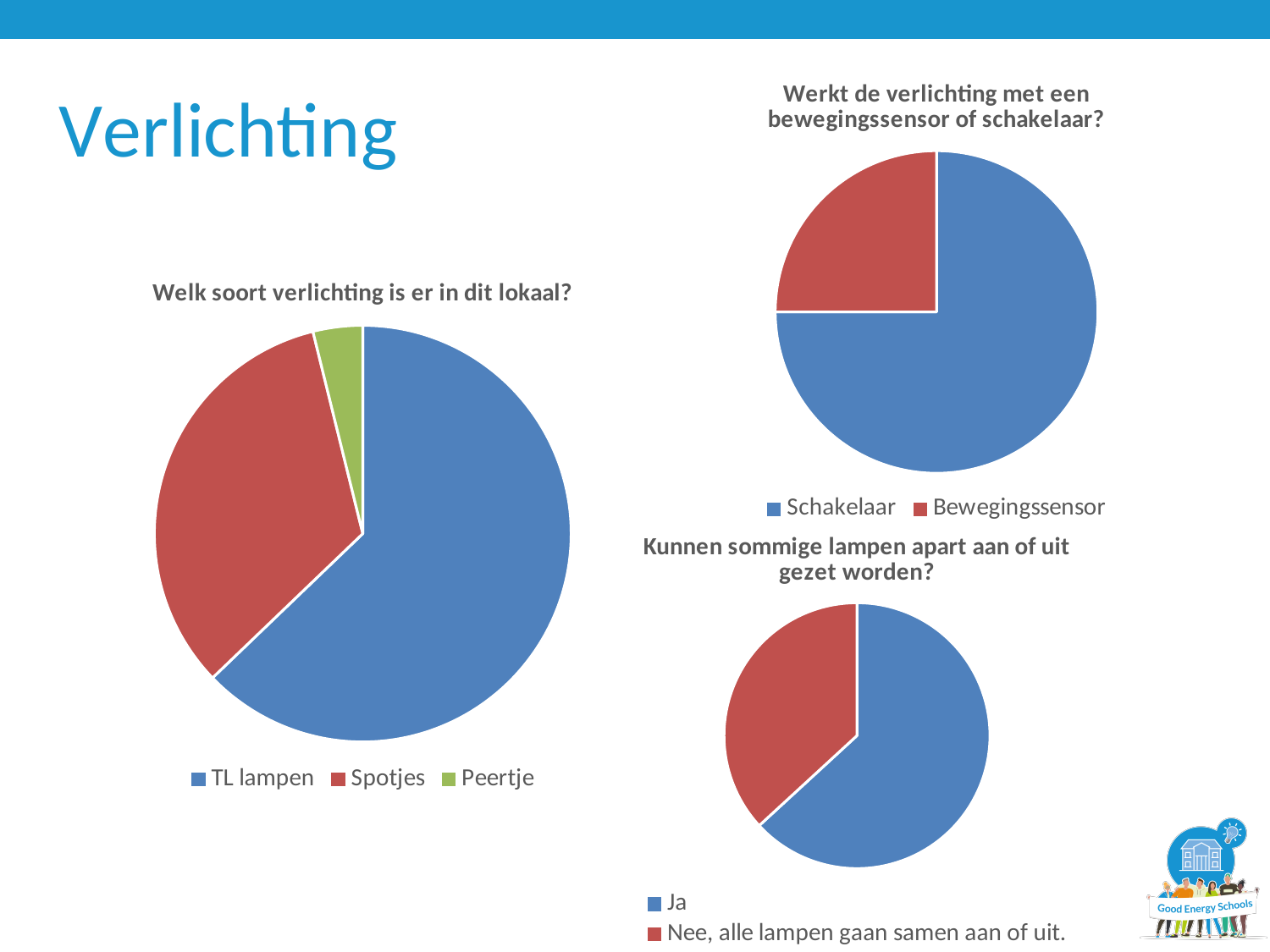
What kind of chart is "Welk soort verlichting is er in dit lokaal?"? Pie chart In the chart "Welk soort verlichting is er in dit lokaal?", what colour is the Peertje slice? Green How many categories does the legend of the chart "Werkt de verlichting met een bewegingssensor of schakelaar?" list? 2 In the chart "Werkt de verlichting met een bewegingssensor of schakelaar?", which category has the largest slice? Schakelaar In the chart "Welk soort verlichting is er in dit lokaal?", which slice is larger: Spotjes or Peertje? Spotjes How many categories does the chart "Welk soort verlichting is er in dit lokaal?" show? 3 In the chart "Kunnen sommige lampen apart aan of uit gezet worden?", which category has the largest slice? Ja How many pie charts are shown on the slide? 3 In the chart "Welk soort verlichting is er in dit lokaal?", which category has the largest slice? TL lampen In the chart "Welk soort verlichting is er in dit lokaal?", which category has the smallest slice? Peertje In the chart "Werkt de verlichting met een bewegingssensor of schakelaar?", which slice is larger: Schakelaar or Bewegingssensor? Schakelaar In the chart "Kunnen sommige lampen apart aan of uit gezet worden?", which category has the smallest slice? Nee, alle lampen gaan samen aan of uit.